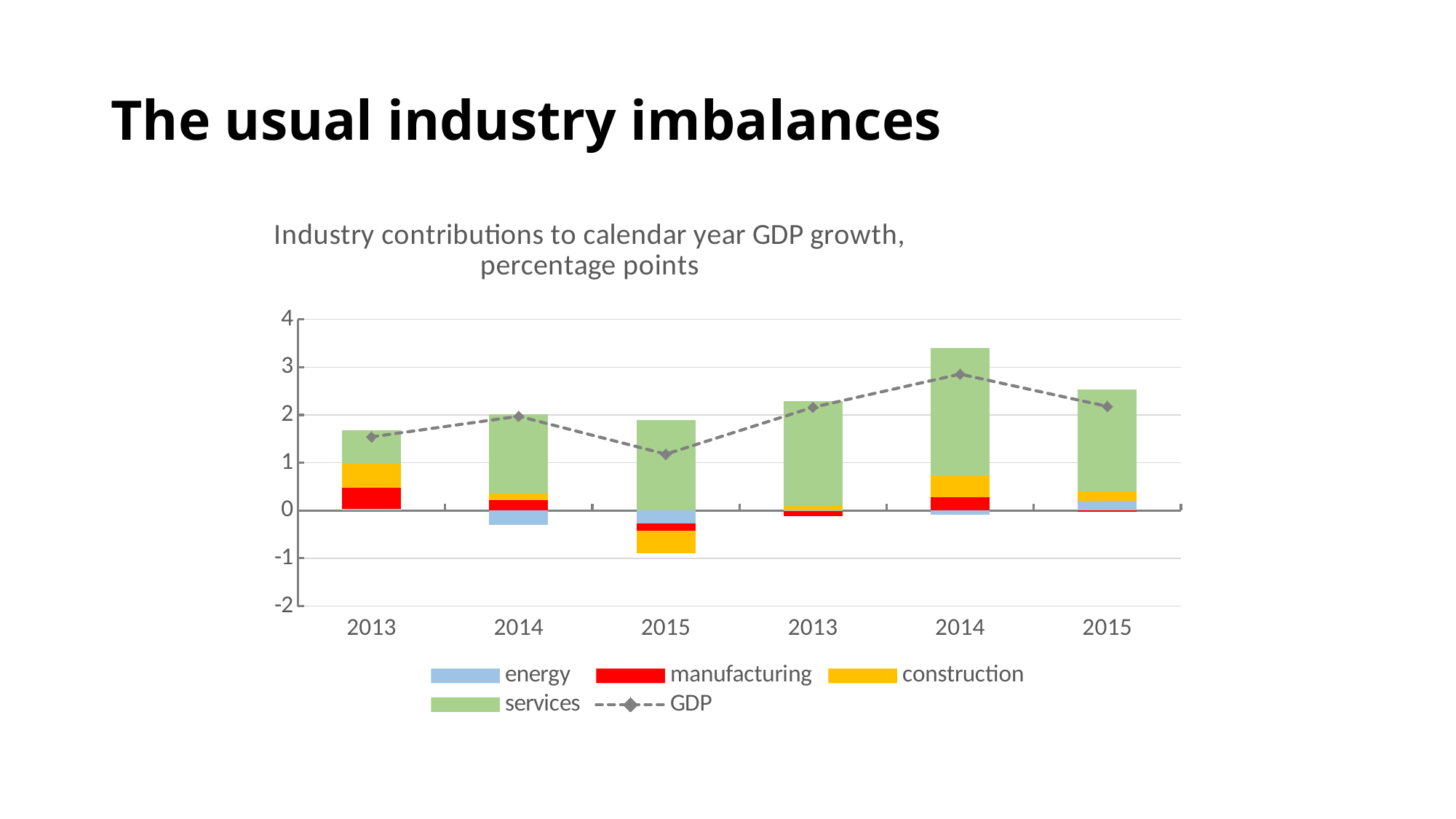
Which series is shown in green in the legend? services At which x-axis position is the GDP line highest? The second 2014 (fifth bar) How many series does the chart's legend list? 5 At which x-axis position is the GDP line lowest? The first 2015 (third bar) Which is larger, the GDP value at the first 2013 (first bar) or at the second 2014 (fifth bar)? The second 2014 (fifth bar) Does the GDP line rise or fall from the first 2014 (second bar) to the first 2015 (third bar)? fall Is the GDP value at the first 2015 (third bar) greater or less than 2? less What kind of chart is this? Stacked bar chart with a line How many bars are plotted along the x axis? 6 Is the GDP value at the second 2014 (fifth bar) greater or less than 2? greater Is the top of the services segment in the second 2014 bar (fifth bar) greater or less than 3? greater What is the title of the chart? Industry contributions to calendar year GDP growth, percentage points